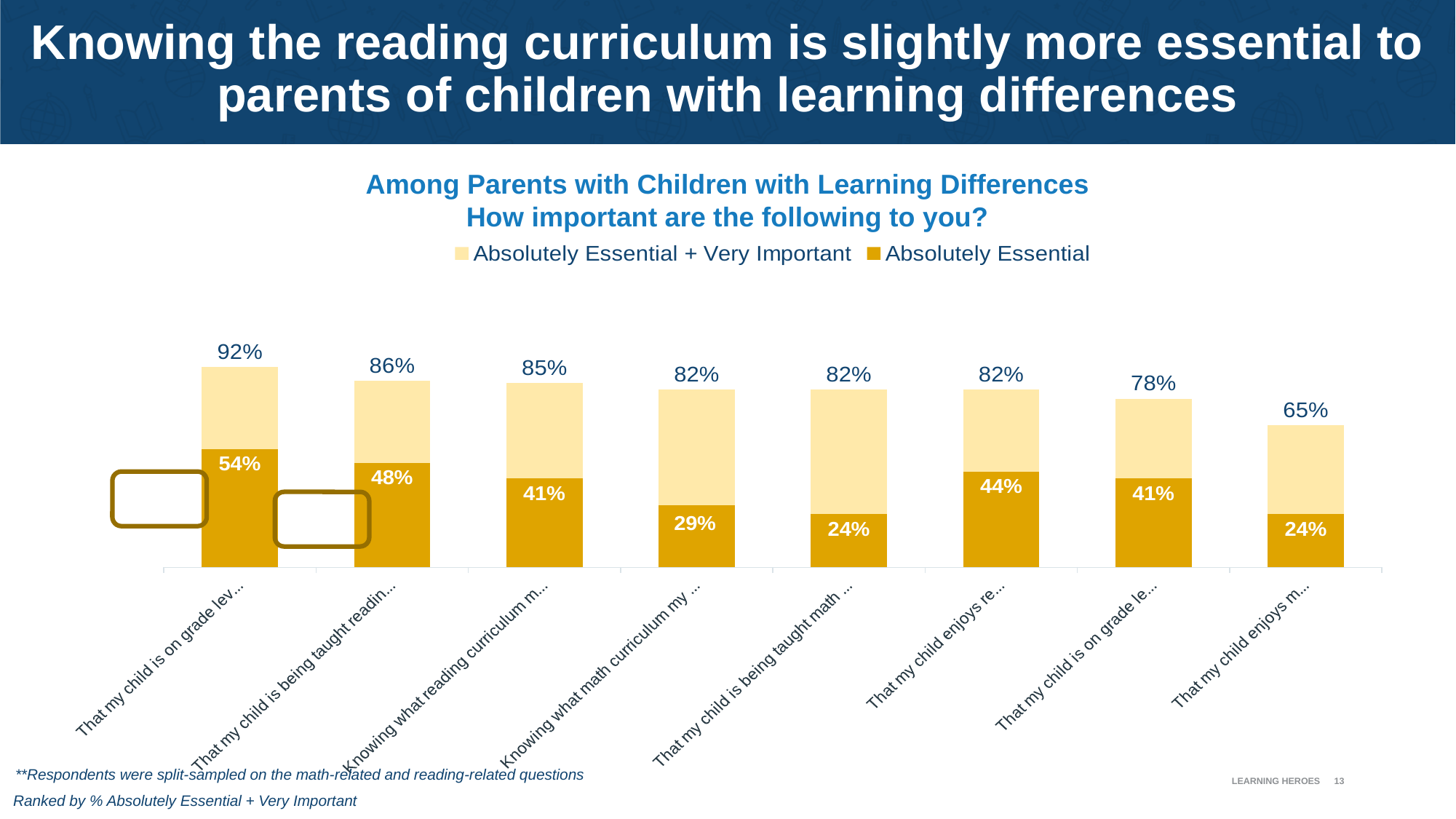
What is the difference in Absolutely Essential values between 'Knowing what reading curriculum...' and 'Knowing what math curriculum...'? 12 percentage points What kind of chart is shown on the slide? Bar chart What is the Absolutely Essential + Very Important value for 'That my child enjoys re...'? 82% Which category has the highest Absolutely Essential + Very Important value? That my child is on grade lev... (leftmost bar), 92% Do the Absolutely Essential + Very Important values rise or fall from left to right across the chart? Fall What is the Absolutely Essential + Very Important value for 'Knowing what reading curriculum...'? 85% How many categories are plotted in the chart? 8 Which has a larger Absolutely Essential value: 'That my child is being taught readin...' or 'That my child is being taught math...'? That my child is being taught readin... What is the Absolutely Essential value for 'That my child is being taught math...'? 24% What is the Absolutely Essential value for 'Knowing what math curriculum...'? 29% Which category has the lowest Absolutely Essential + Very Important value? That my child enjoys m... (rightmost bar), 65% How many series does the chart legend list? 2